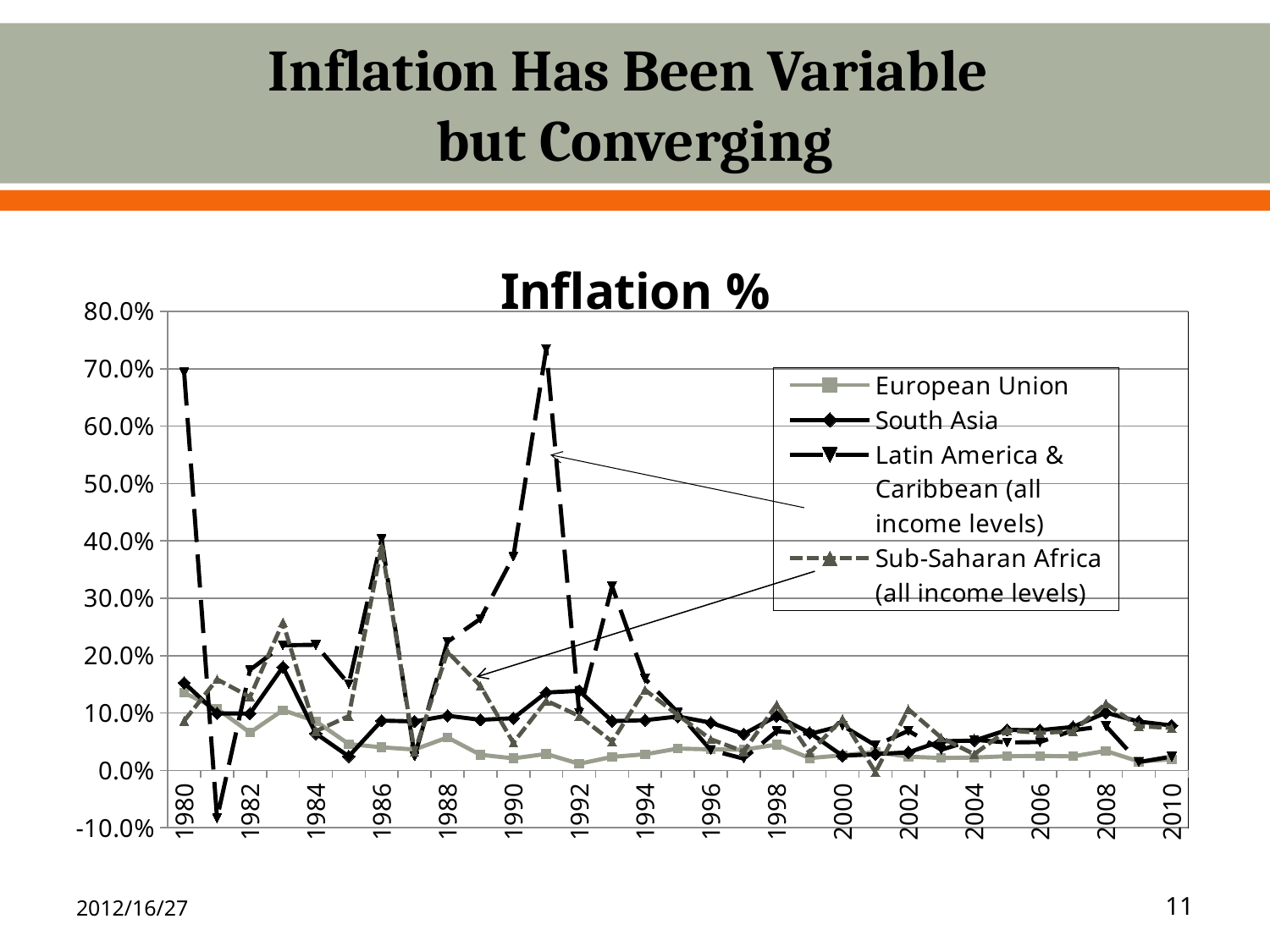
What is the title of the chart? Inflation % In 1991, which is larger: the value for Latin America & Caribbean or the value for the European Union? Latin America & Caribbean In which year does the Latin America & Caribbean series reach its peak? 1991 What kind of chart is shown on the slide? line chart Which series reaches the highest value anywhere on the chart? Latin America & Caribbean (all income levels) Is the value for Latin America & Caribbean in 1981 greater or less than 0.0%? less How many series does the legend of the chart list? 4 Is the value for the European Union in 2010 greater or less than 10.0%? less Does the Latin America & Caribbean series rise or fall overall from 1991 to 2010? fall Is the value for Sub-Saharan Africa in 1983 greater or less than 20.0%? greater What is the highest value shown on the y axis of the chart? 80.0%